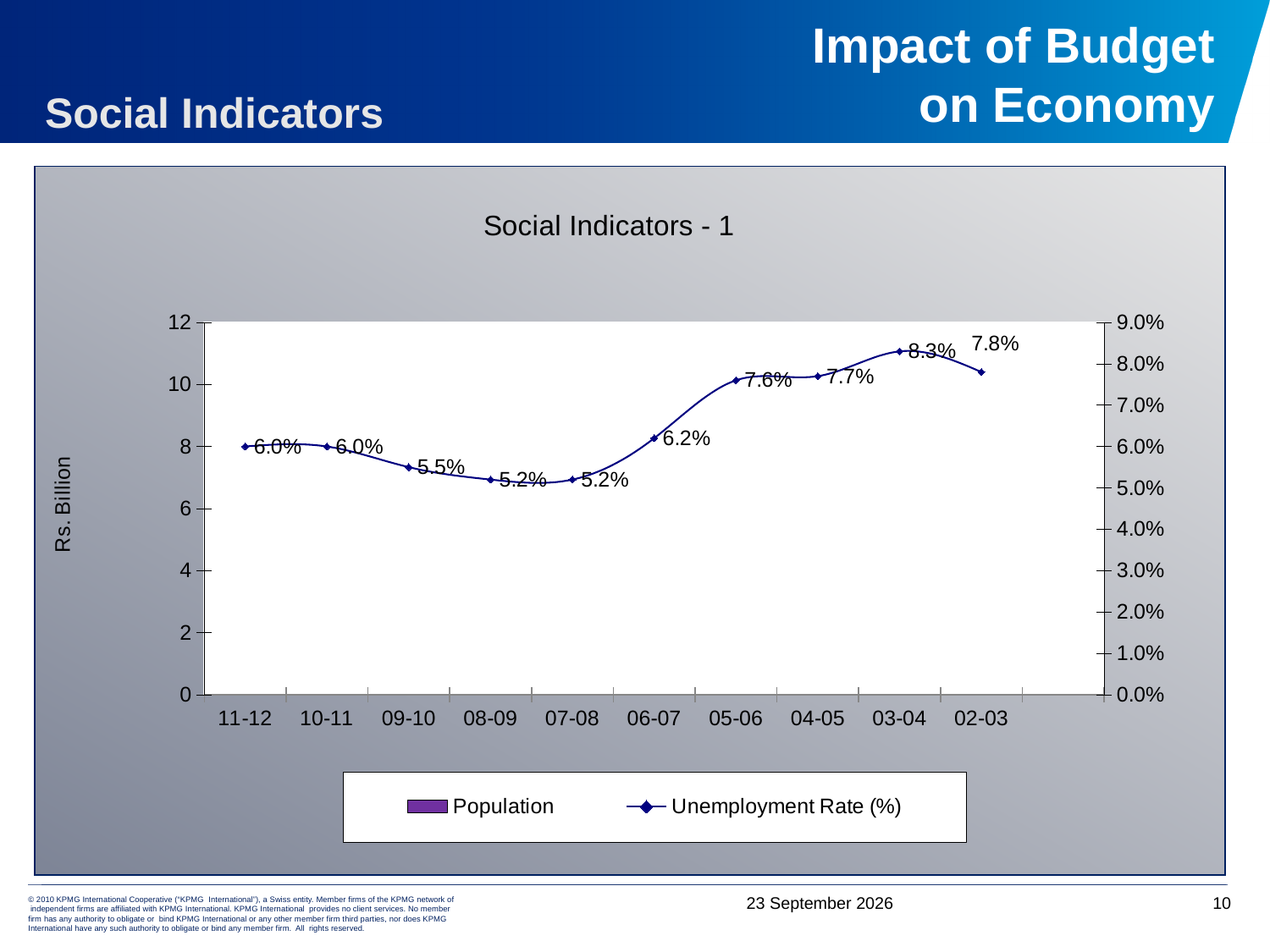
What kind of chart is shown? line chart How many categories are shown on the x axis? 10 What is the title of the chart? Social Indicators - 1 Which category has the highest Unemployment Rate (%)? 03-04 Is the Unemployment Rate (%) for 05-06 greater or less than 7.0%? greater Which has a higher Unemployment Rate (%), 06-07 or 05-06? 05-06 Does the Unemployment Rate (%) rise or fall from 06-07 to 03-04 along the x axis? rise What is the Unemployment Rate (%) for 03-04? 8.3% What is the Unemployment Rate (%) for 02-03? 7.8% What is the difference between the Unemployment Rate (%) for 03-04 and for 08-09? 3.1 percentage points What is the Unemployment Rate (%) for 09-10? 5.5% How many series does the legend list? 2